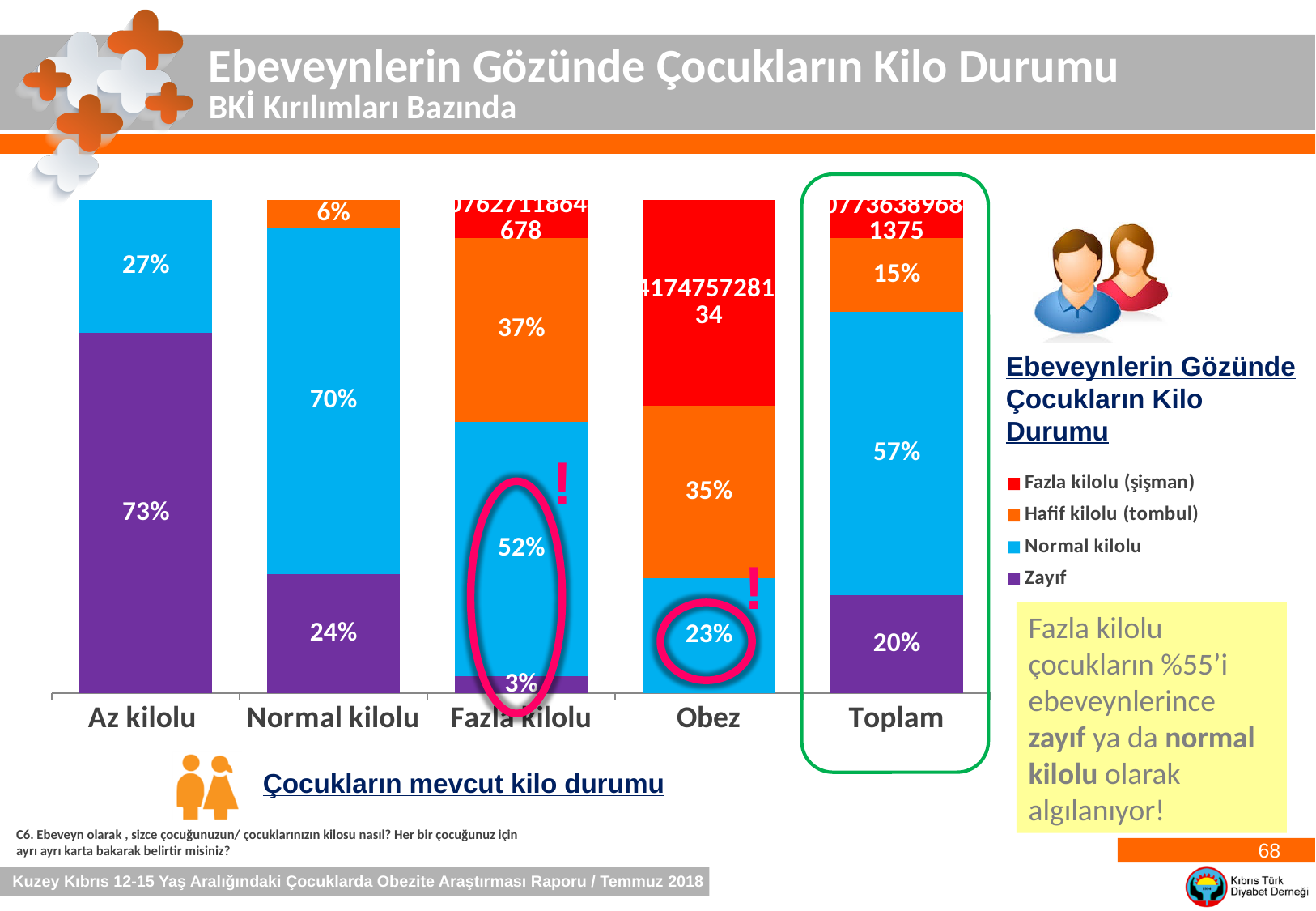
Which category has the larger Hafif kilolu (tombul) value, Fazla kilolu or Obez? Fazla kilolu How many categories are shown along the x axis? 5 What is the Zayıf value for the Az kilolu category? 73% What is the Normal kilolu value for the Fazla kilolu category? 52% What is the Hafif kilolu (tombul) value for the Obez category? 35% How many series does the legend list? 4 What kind of chart is shown on the slide? Stacked bar chart Which category has the highest Zayıf value? Az kilolu What is the Normal kilolu value for the Normal kilolu category? 70% What is the Hafif kilolu (tombul) value for the Toplam category? 15% What is the difference between the Normal kilolu value for the Normal kilolu category and the Normal kilolu value for the Fazla kilolu category? 18 percentage points What is the Normal kilolu value for the Toplam category? 57%